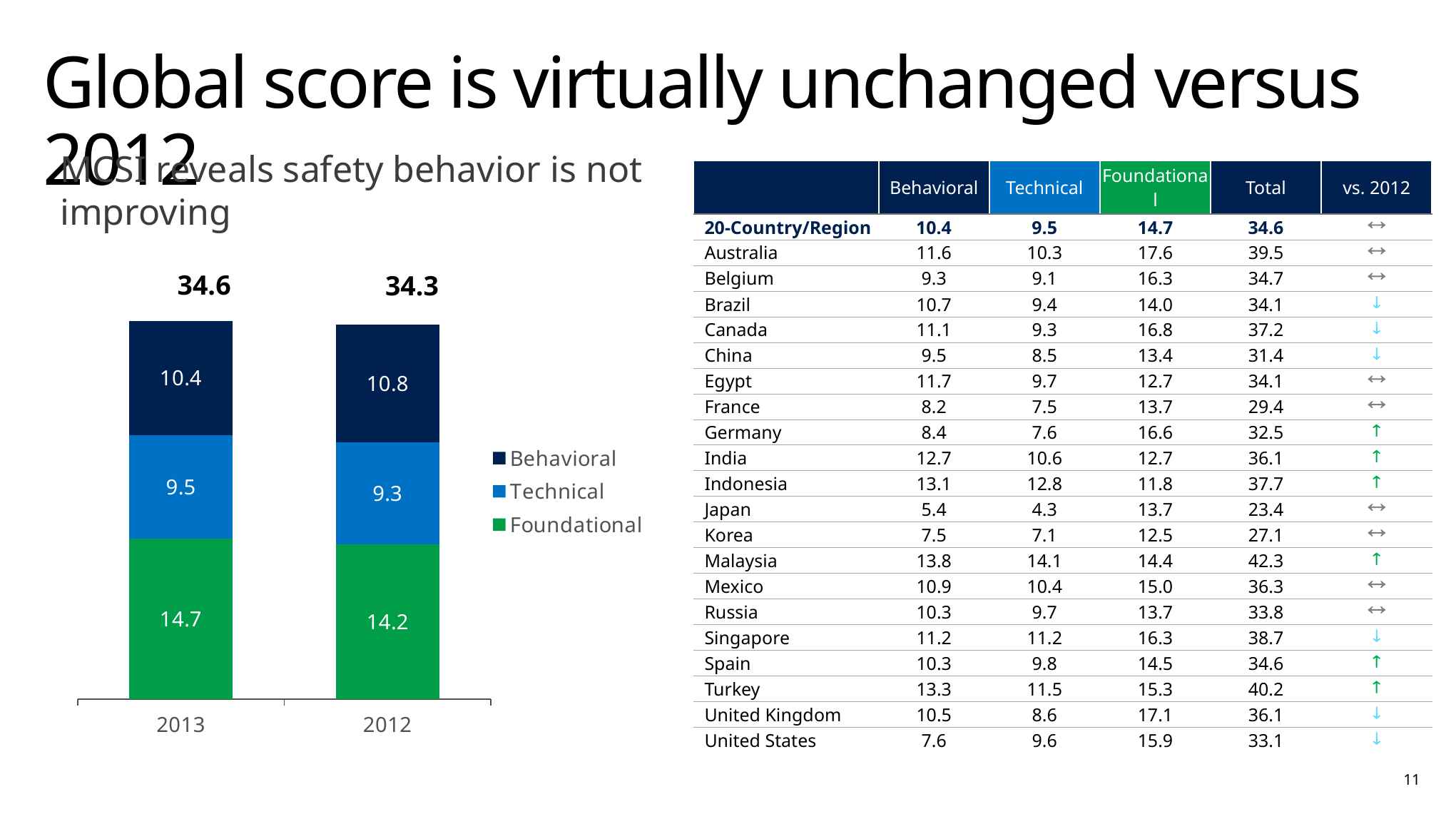
Which series has the largest value in the 2013 bar? Foundational What is the total of the stacked bar for 2012? 34.3 What is the total of the stacked bar for 2013? 34.6 What is the Technical value for 2013 in the stacked bar chart? 9.5 What is the Behavioral value for 2012 in the stacked bar chart? 10.8 What is the difference between the Foundational values for 2013 and 2012? 0.5 Which year has the larger Technical value, 2013 or 2012? 2013 What is the Foundational value for 2013 in the stacked bar chart? 14.7 How many series does the chart legend list? 3 What is the difference between the Behavioral values for 2012 and 2013? 0.4 How many bars are shown in the chart? 2 What kind of chart is shown on the left of the slide? Stacked bar chart